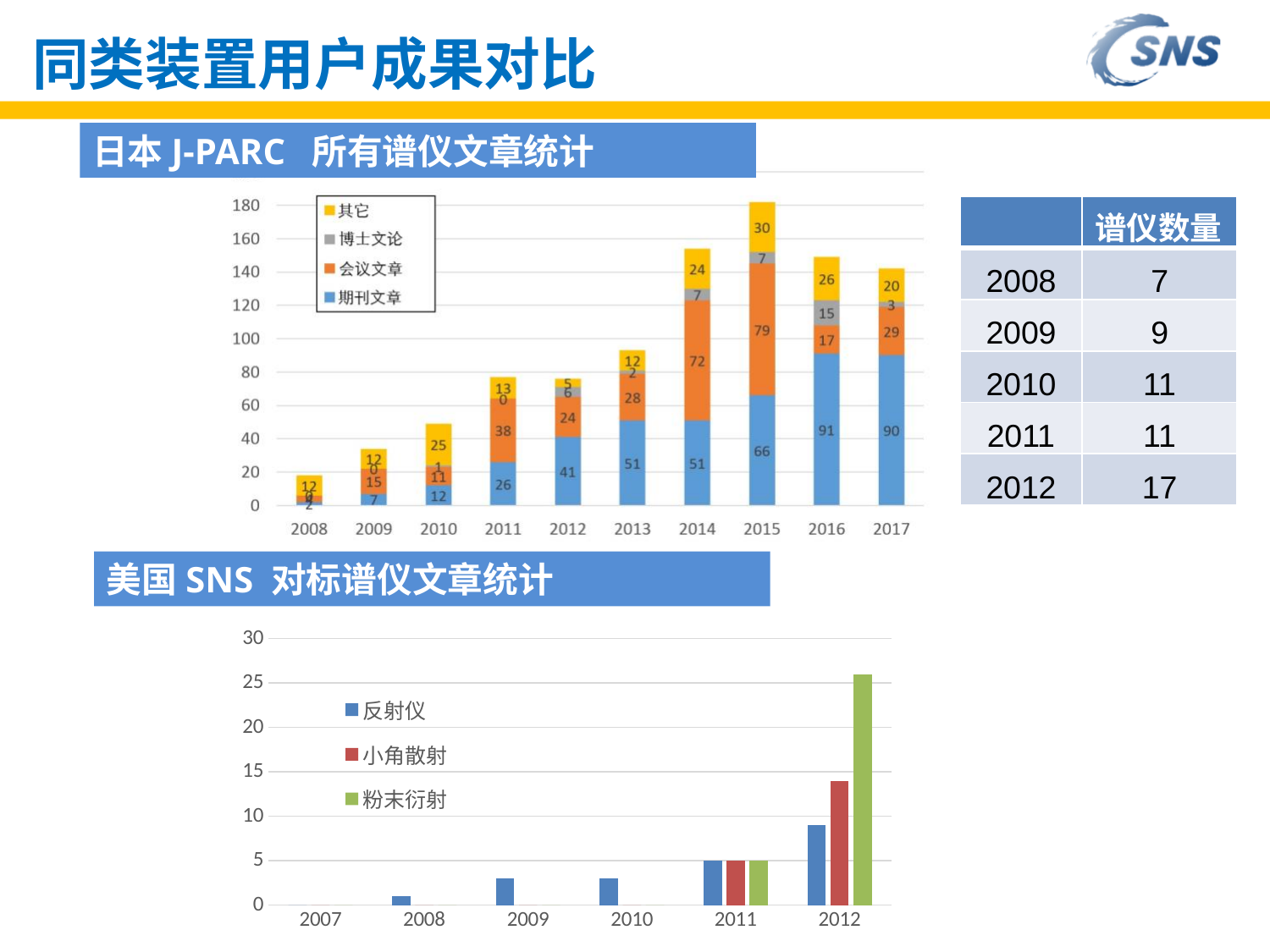
In the top chart (日本 J-PARC 所有谱仪文章统计), what is the value of 其它 for 2014? 24 In the bottom chart (美国 SNS 对标谱仪文章统计), is the value of 粉末衍射 for 2012 greater or less than 25? greater In the top chart (日本 J-PARC 所有谱仪文章统计), what is the difference between the 期刊文章 values for 2016 and 2015? 25 What kind of chart is the bottom chart (美国 SNS 对标谱仪文章统计)? bar chart In the top chart (日本 J-PARC 所有谱仪文章统计), what is the total of the stacked bar for 2015? 182 In the bottom chart (美国 SNS 对标谱仪文章统计), which series has the highest value in 2012? 粉末衍射 In the top chart (日本 J-PARC 所有谱仪文章统计), what is the value of 期刊文章 for 2016? 91 In the top chart (日本 J-PARC 所有谱仪文章统计), what is the value of 会议文章 for 2015? 79 In the top chart (日本 J-PARC 所有谱仪文章统计), what is the value of 博士文论 for 2016? 15 How many years are shown on the x axis of the top chart (日本 J-PARC 所有谱仪文章统计)? 10 In the top chart (日本 J-PARC 所有谱仪文章统计), which year has the tallest stacked bar? 2015 How many series does the legend of the top chart (日本 J-PARC 所有谱仪文章统计) list? 4